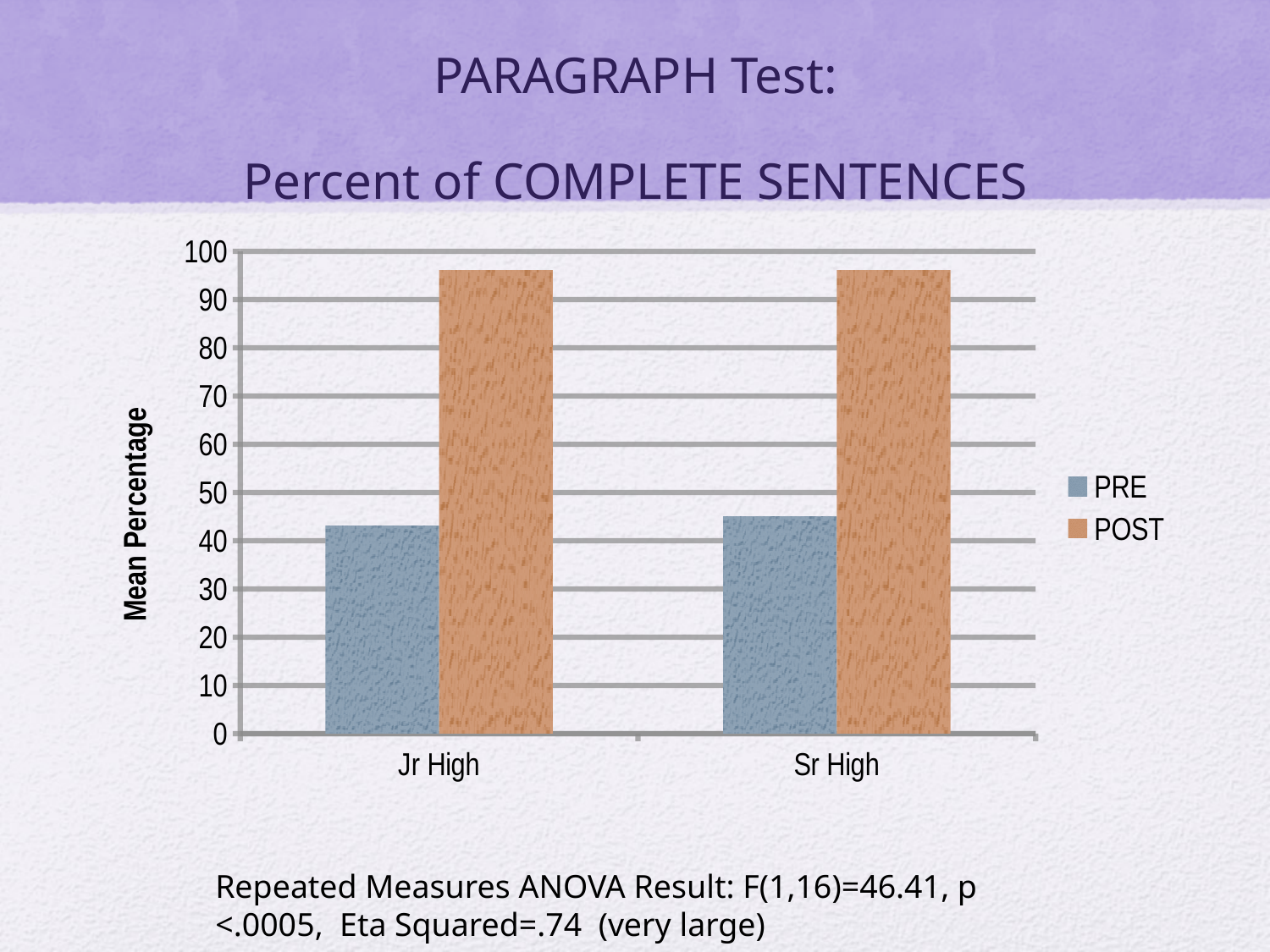
Is the PRE value for Sr High greater or less than 30? greater How many series does the legend list? 2 Is the POST value for Sr High greater or less than 80? greater How many categories are shown on the x axis? 2 What is the label of the vertical axis? Mean Percentage Is the POST value for Jr High greater or less than 90? greater For Jr High, which is larger, the PRE value or the POST value? POST Which series are listed in the legend? PRE and POST For Sr High, which is larger, the PRE value or the POST value? POST What kind of chart is shown on the slide? bar chart